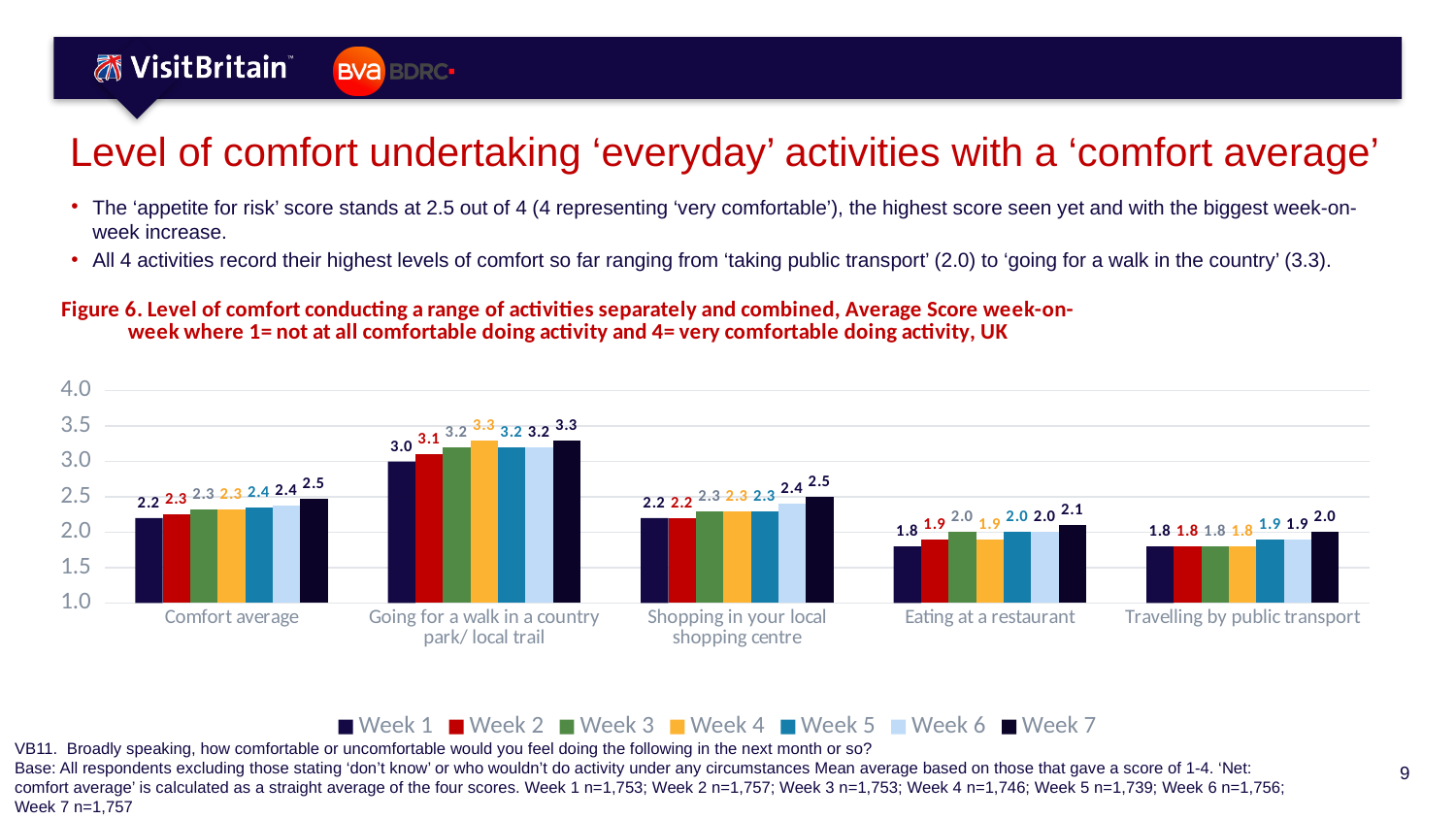
Which activity has the highest Week 7 value? Going for a walk in a country park/ local trail Which activity has the lowest Week 1 value, 'Eating at a restaurant' or 'Shopping in your local shopping centre'? Eating at a restaurant What kind of chart is shown on the slide? Bar chart Do the values for 'Comfort average' generally rise or fall from Week 1 to Week 7? Rise What is the Week 7 value for 'Comfort average'? 2.5 What is the Week 1 value for 'Going for a walk in a country park/ local trail'? 3.0 What is the difference between the Week 7 values for 'Shopping in your local shopping centre' and 'Travelling by public transport'? 0.5 How many activity categories are shown on the x axis? 5 What is the Week 4 value for 'Eating at a restaurant'? 1.9 How many series does the legend list? 7 What is the Week 7 value for 'Travelling by public transport'? 2.0 What is the difference between the Week 7 and Week 1 values for 'Going for a walk in a country park/ local trail'? 0.3